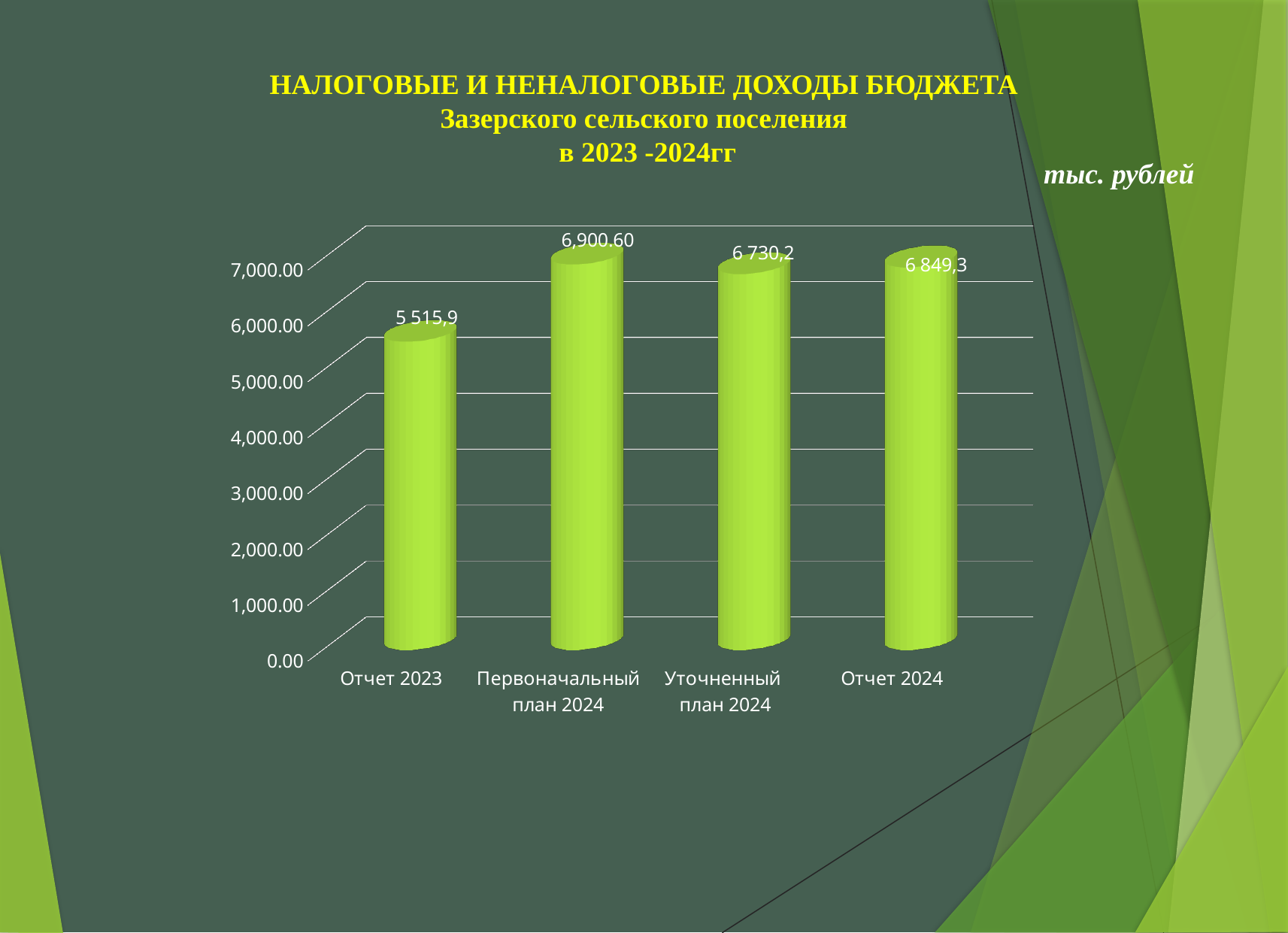
What is the value for Уточненный план 2024? 6 730,2 What is the value for Отчет 2024? 6 849,3 What kind of chart is shown on the slide? bar chart Which is larger, Отчет 2024 or Уточненный план 2024? Отчет 2024 What is the difference between Отчет 2024 and Отчет 2023? 1 333,4 What is the value for Отчет 2023? 5 515,9 What is the value for Первоначальный план 2024? 6,900.60 Which category has the highest value? Первоначальный план 2024 What is the difference between Отчет 2024 and Уточненный план 2024? 119,1 How many categories are shown on the x axis? 4 Is the value for Отчет 2023 greater or less than 6,000.00? less Which category has the lowest value? Отчет 2023